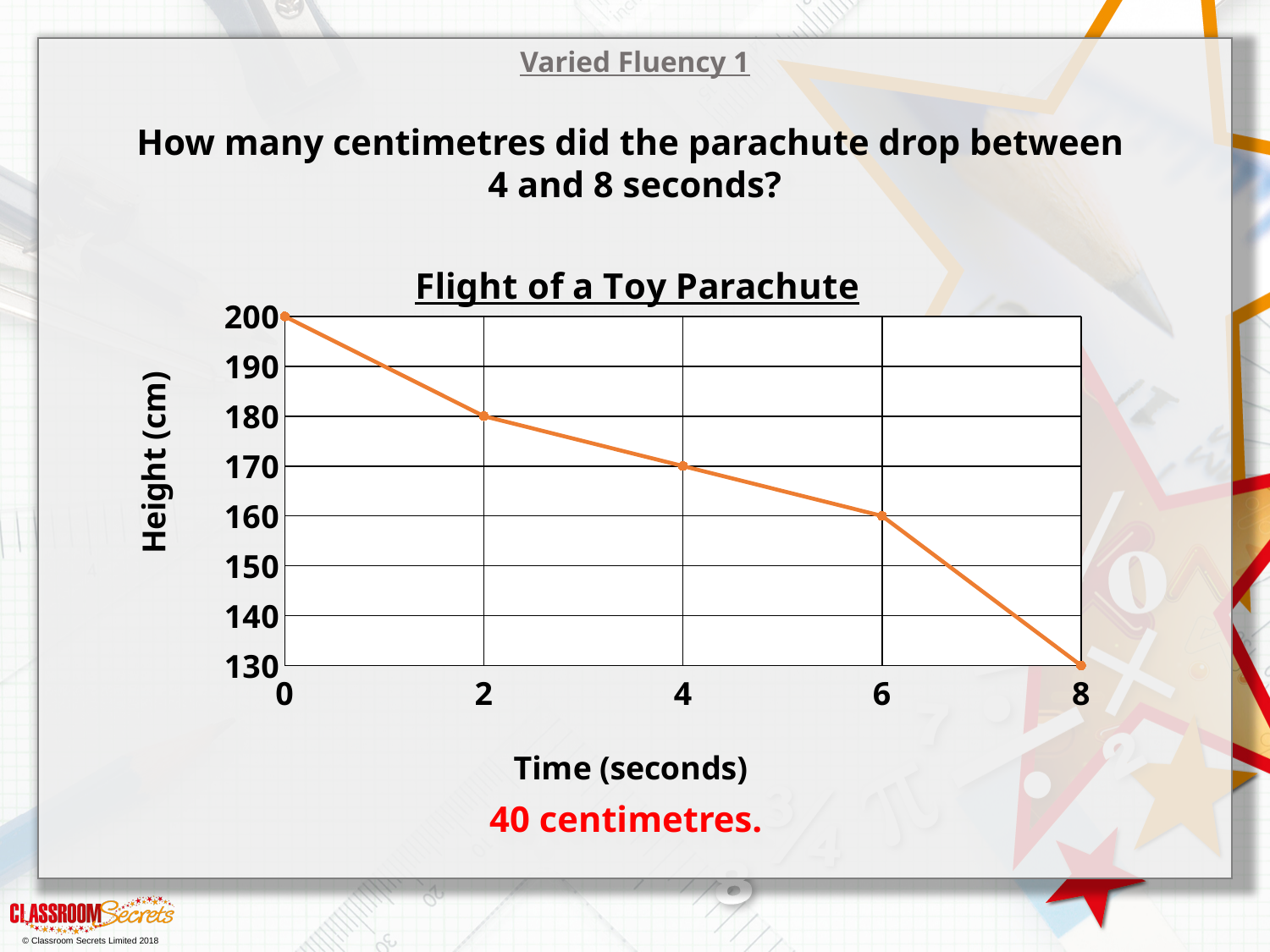
At which time is the parachute's height highest? 0 At which time is the parachute's height lowest? 8 How many data points are plotted on the line? 5 What is the title of the chart? Flight of a Toy Parachute What is the height of the parachute at 0 seconds? 200 What is the height of the parachute at 4 seconds? 170 What type of chart is shown on the slide? line chart What is the height of the parachute at 2 seconds? 180 How much does the height drop between 0 and 2 seconds? 20 What is the height of the parachute at 8 seconds? 130 Does the height rise or fall as time increases? fall How much does the height drop between 4 and 8 seconds? 40